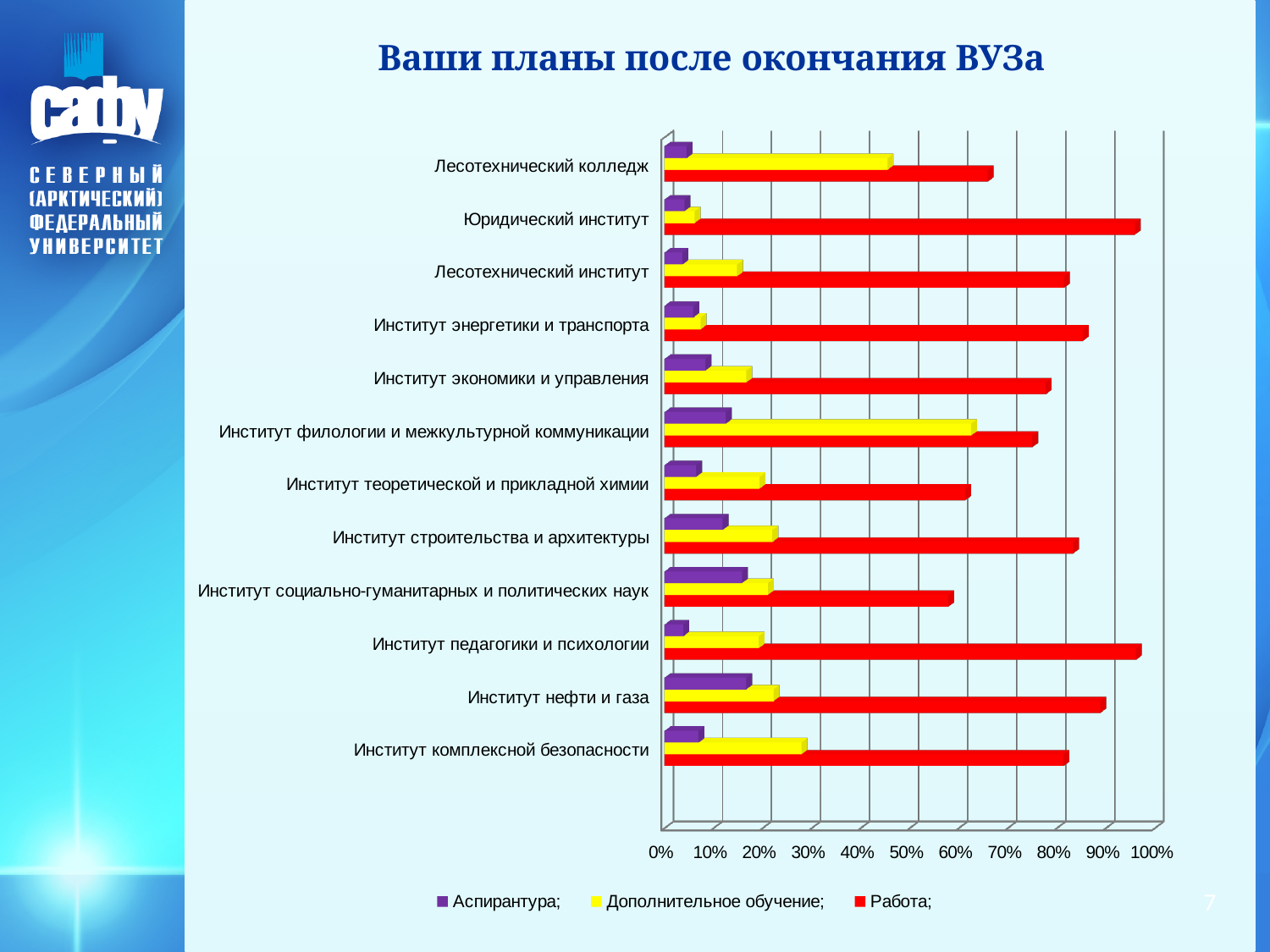
Is the value of Работа for Юридический институт greater or less than 90%? greater How many series does the legend list? 3 What is the title of the chart on the slide? Ваши планы после окончания ВУЗа How many institutes (categories) are listed on the chart? 12 Which category has the highest value for Дополнительное обучение? Институт филологии и межкультурной коммуникации Which series is shown in red in the legend? Работа Is the value of Работа for Лесотехнический колледж greater or less than 60%? greater Which has the larger value for Аспирантура: Институт нефти и газа or Институт педагогики и психологии? Институт нефти и газа What kind of chart is shown on the slide? bar chart Is the value of Дополнительное обучение for Лесотехнический колледж greater or less than 40%? greater Which has the larger value for Работа: Юридический институт or Лесотехнический колледж? Юридический институт